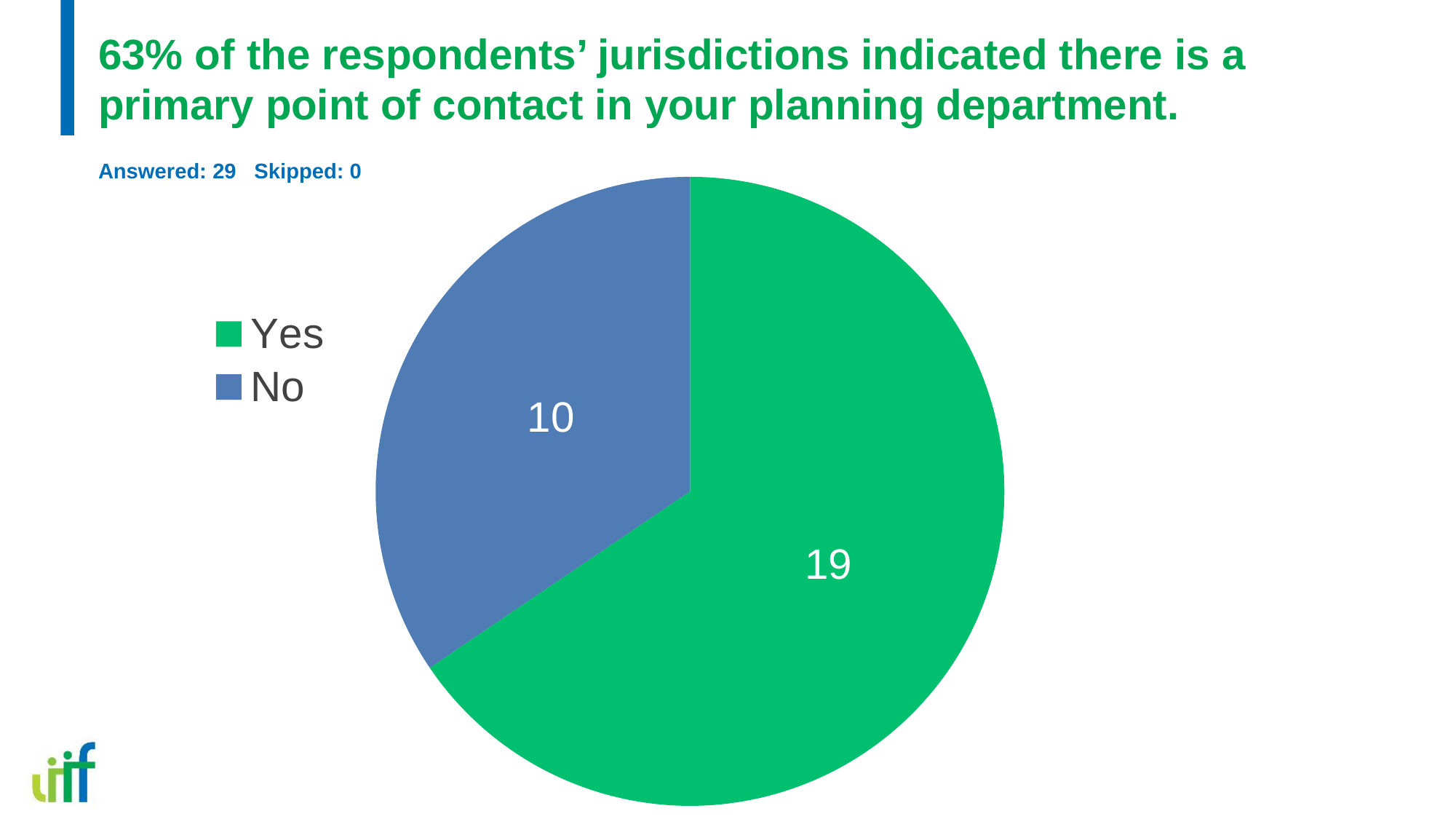
How many respondents answered the question according to the slide? 29 What is the value for the No slice? 10 What is the total of the two slices? 29 What is the value for the Yes slice? 19 Which is larger, the Yes slice or the No slice? Yes Which slice is the smallest? No How many slices does the pie chart have? 2 How many entries does the legend list? 2 What kind of chart is shown on the slide? pie chart What is the difference between the Yes and No values? 9 What colour is the Yes slice? green Which slice is the largest? Yes